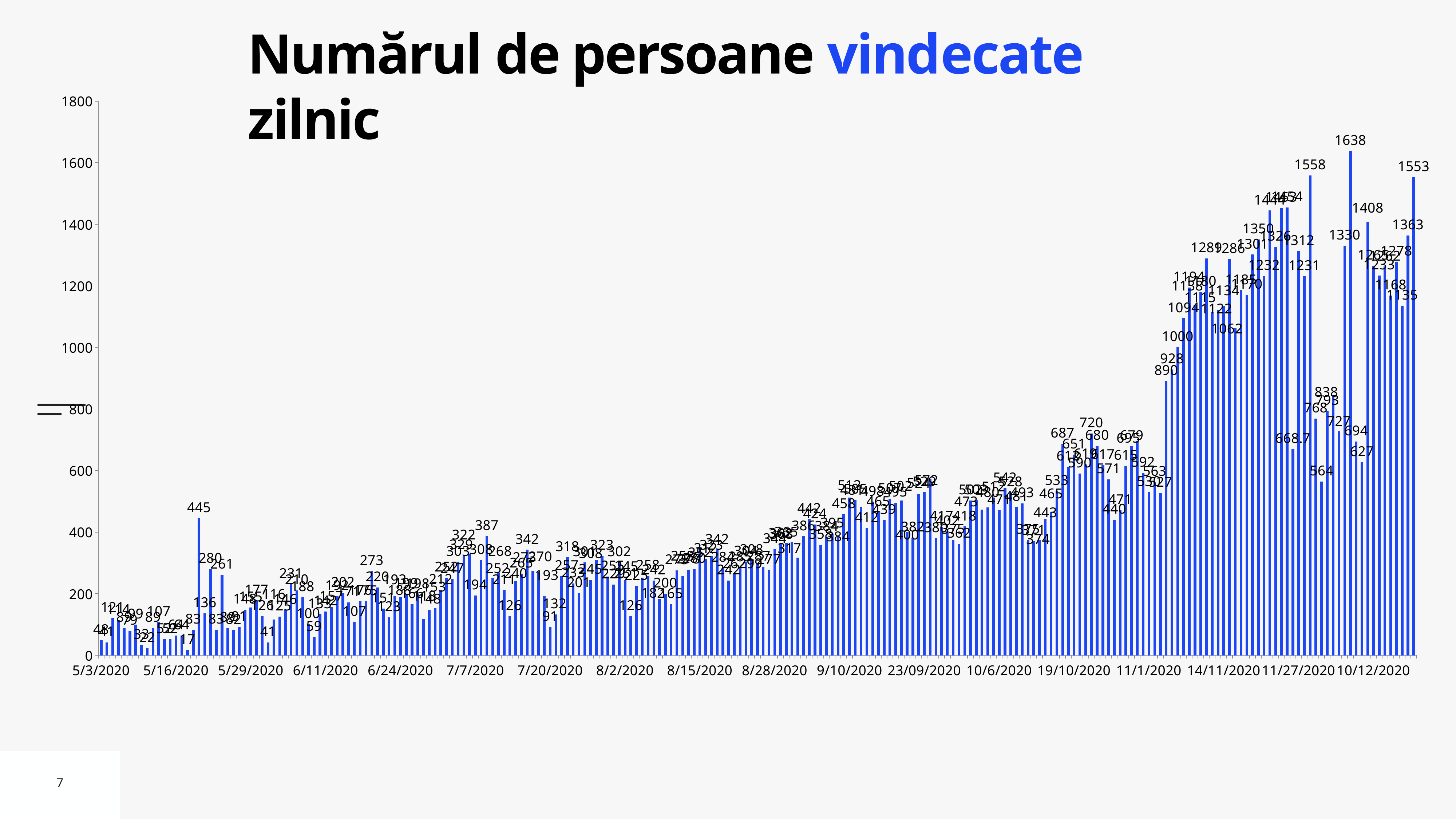
What kind of chart is shown on the slide? bar chart Is the value of the last bar on the right greater or less than 1400? greater Which is larger, the bar labelled 1558 or the bar labelled 1408? 1558 Overall, do the daily values rise or fall from left to right along the x axis? rise What is the highest daily value shown on the chart? 1638 What is the difference between the highest bar (1638) and the bar labelled 1558? 80 What is the value of the last bar on the right of the chart? 1553 What is the title of the chart? Numărul de persoane vindecate zilnic What is the lowest daily value labelled on the chart? 17 Is the tallest bar in May 2020 (labelled 445) greater or less than 400? greater What is the difference between the highest bar (1638) and the last bar (1553)? 85 What is the maximum value shown on the vertical axis? 1800